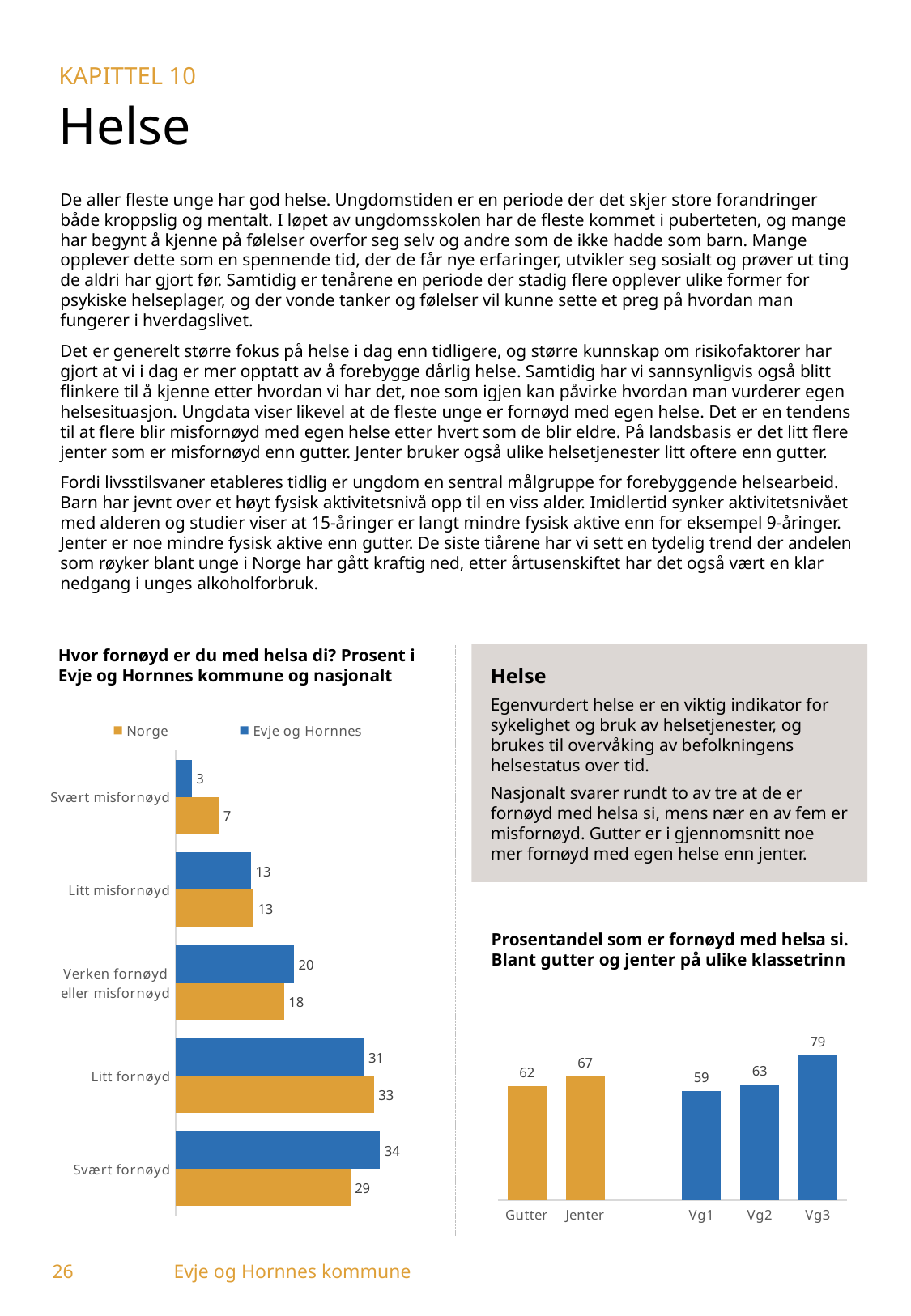
In the chart 'Prosentandel som er fornøyd med helsa si', do the values rise or fall from Vg1 to Vg3? Rise In the chart 'Hvor fornøyd er du med helsa di?', which is larger in the category 'Litt fornøyd': Norge or Evje og Hornnes? Norge In the chart 'Hvor fornøyd er du med helsa di?', what is the value for Evje og Hornnes in the category 'Svært fornøyd'? 34 In the chart 'Hvor fornøyd er du med helsa di?', what is the value for Norge in the category 'Svært misfornøyd'? 7 How many categories are shown in the chart 'Hvor fornøyd er du med helsa di?'? 5 How many series does the legend list in the chart 'Hvor fornøyd er du med helsa di?'? 2 In the chart 'Hvor fornøyd er du med helsa di?', what is the difference between Evje og Hornnes and Norge in the category 'Svært fornøyd'? 5 In the chart 'Prosentandel som er fornøyd med helsa si', what is the value for Vg3? 79 In the chart 'Prosentandel som er fornøyd med helsa si', what is the difference between Jenter and Gutter? 5 What kind of chart is 'Prosentandel som er fornøyd med helsa si'? Bar chart In the chart 'Hvor fornøyd er du med helsa di?', which category has the lowest value for Evje og Hornnes? Svært misfornøyd In the chart 'Hvor fornøyd er du med helsa di?', which category has the highest value for Norge? Litt fornøyd